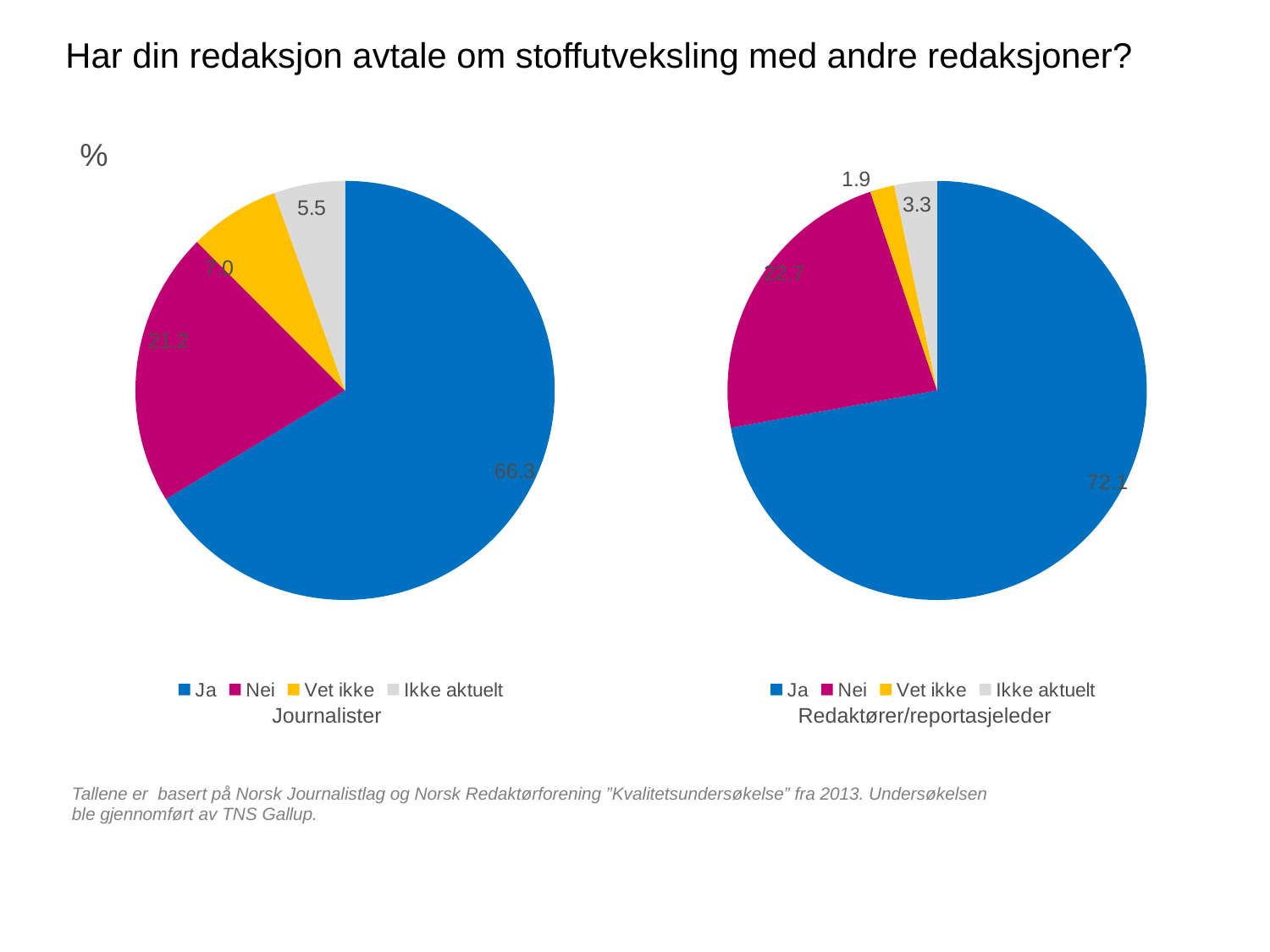
What kind of chart is used for the Redaktører/reportasjeleder data? Pie chart In the Journalister pie chart, what is the value for Nei? 21.2 What is the difference between the Ja value in the Redaktører/reportasjeleder chart and the Ja value in the Journalister chart? 5.8 In the Journalister pie chart, which category has the largest slice? Ja Which is larger: Nei in the Journalister chart or Nei in the Redaktører/reportasjeleder chart? Nei in the Redaktører/reportasjeleder chart In the Redaktører/reportasjeleder pie chart, what is the value for Ikke aktuelt? 3.3 In the Redaktører/reportasjeleder pie chart, which category has the smallest slice? Vet ikke In the Redaktører/reportasjeleder pie chart, what is the value for Ja? 72.1 In the Redaktører/reportasjeleder pie chart, what is the value for Vet ikke? 1.9 How many categories does the legend of the Journalister chart list? 4 In the Journalister pie chart, what is the value for Ja? 66.3 In the Journalister pie chart, what is the value for Ikke aktuelt? 5.5